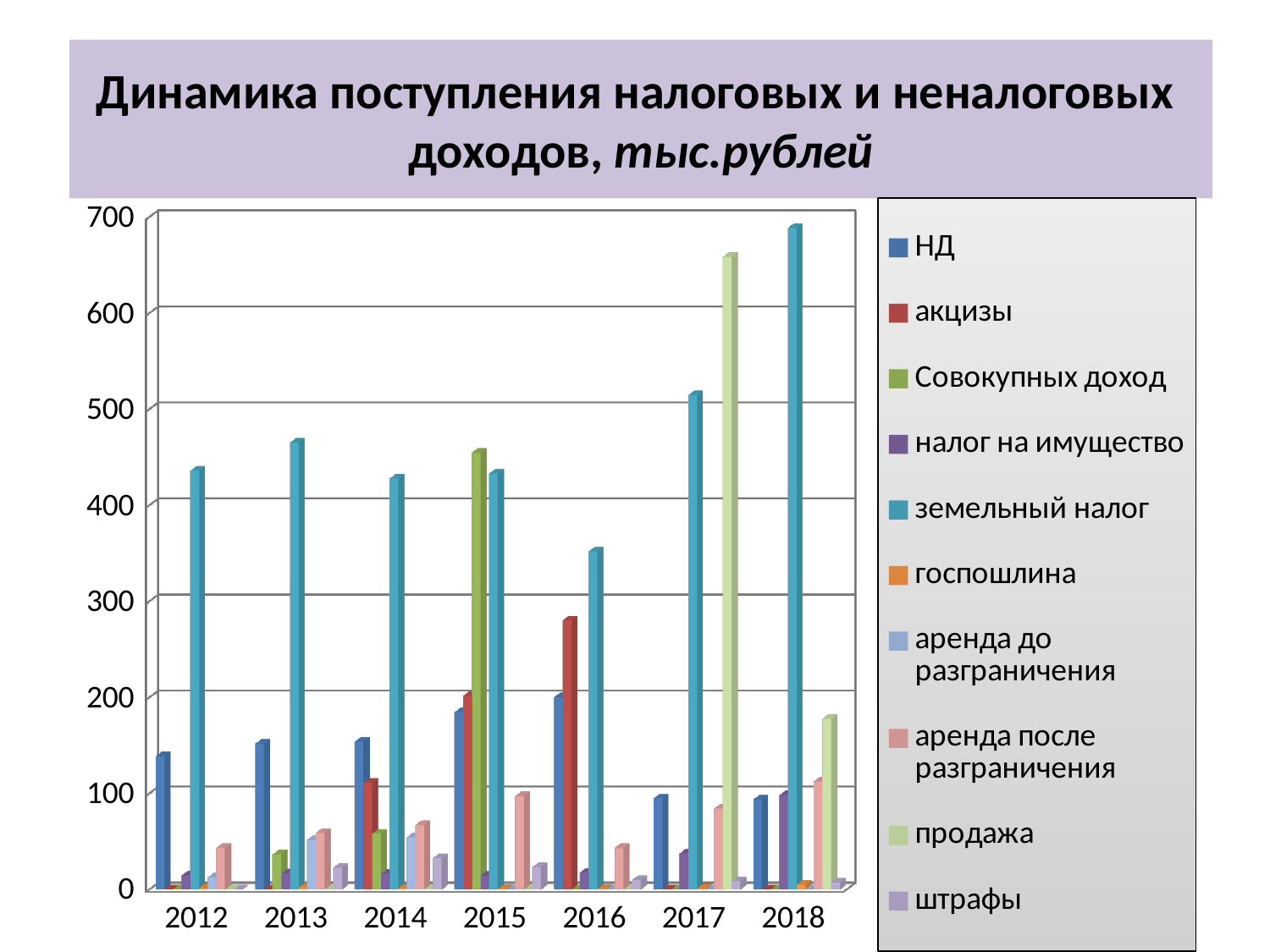
Is the value for земельный налог in 2018 greater or less than 600? greater Is the value for продажа in 2017 greater or less than 600? greater What kind of chart is shown on the slide? bar chart Which is larger: земельный налог in 2018 or земельный налог in 2016? земельный налог in 2018 How many years are shown along the x axis? 7 In which year is земельный налог highest? 2018 Is the value for акцизы in 2016 greater or less than 200? greater In which year is земельный налог lowest? 2016 Which series is listed first in the legend? НД In 2017, which series has the highest value? продажа How many series does the legend list? 10